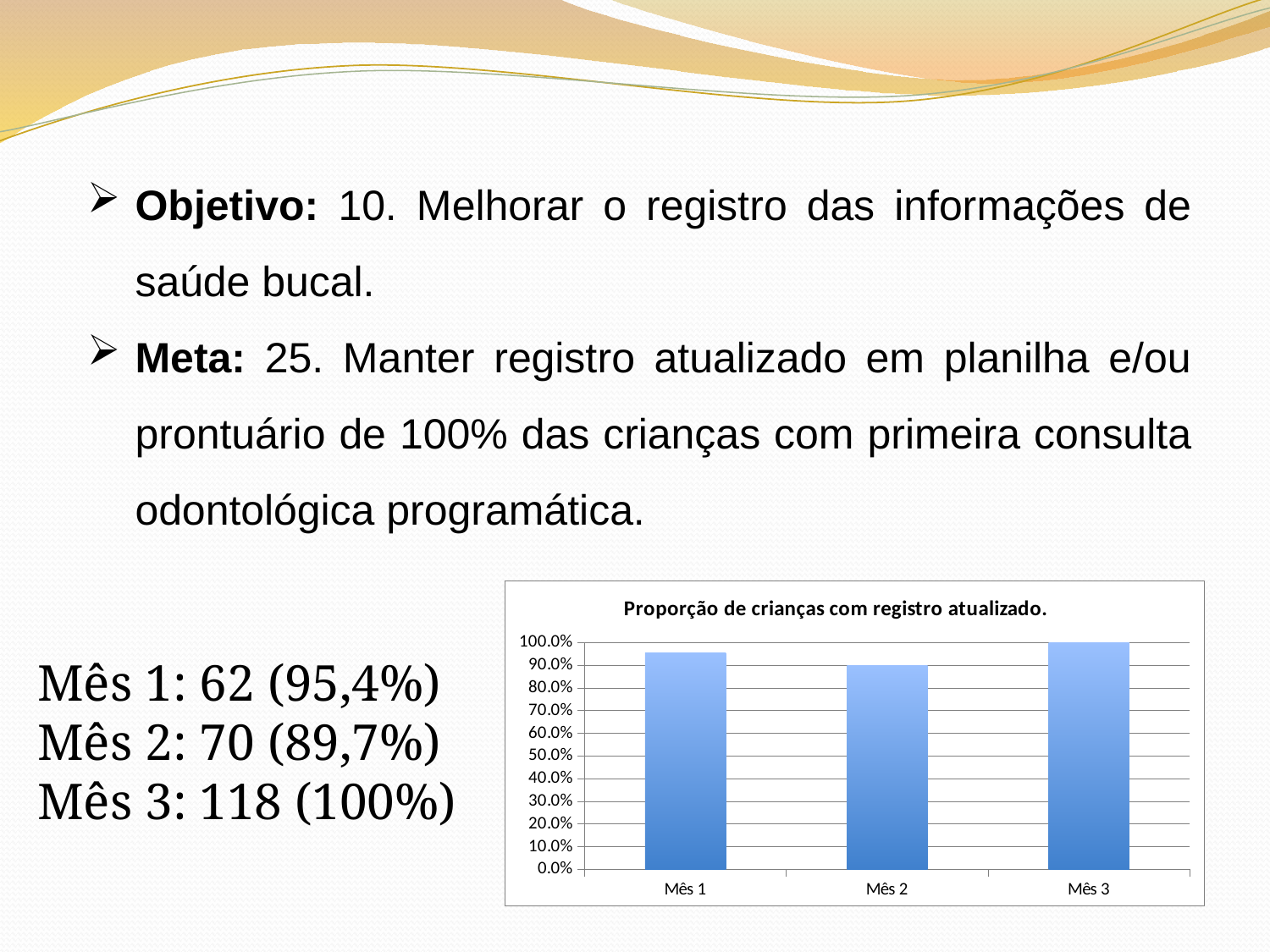
How many categories (months) are plotted on the chart? 3 Which month has the lowest proportion of children with updated records? Mês 2 Is the value for Mês 1 greater or less than 90.0%? greater What is the maximum value shown on the chart's vertical axis? 100.0% Which is larger, the value for Mês 1 or the value for Mês 2? Mês 1 Is the value for Mês 2 greater or less than 80.0%? greater What is the value plotted for Mês 3? 100.0% Which month has the highest proportion of children with updated records? Mês 3 Does the value rise or fall from Mês 2 to Mês 3? rise What kind of chart is shown on the slide? bar chart What is the title of the chart? Proporção de crianças com registro atualizado. Does the value rise or fall from Mês 1 to Mês 2? fall